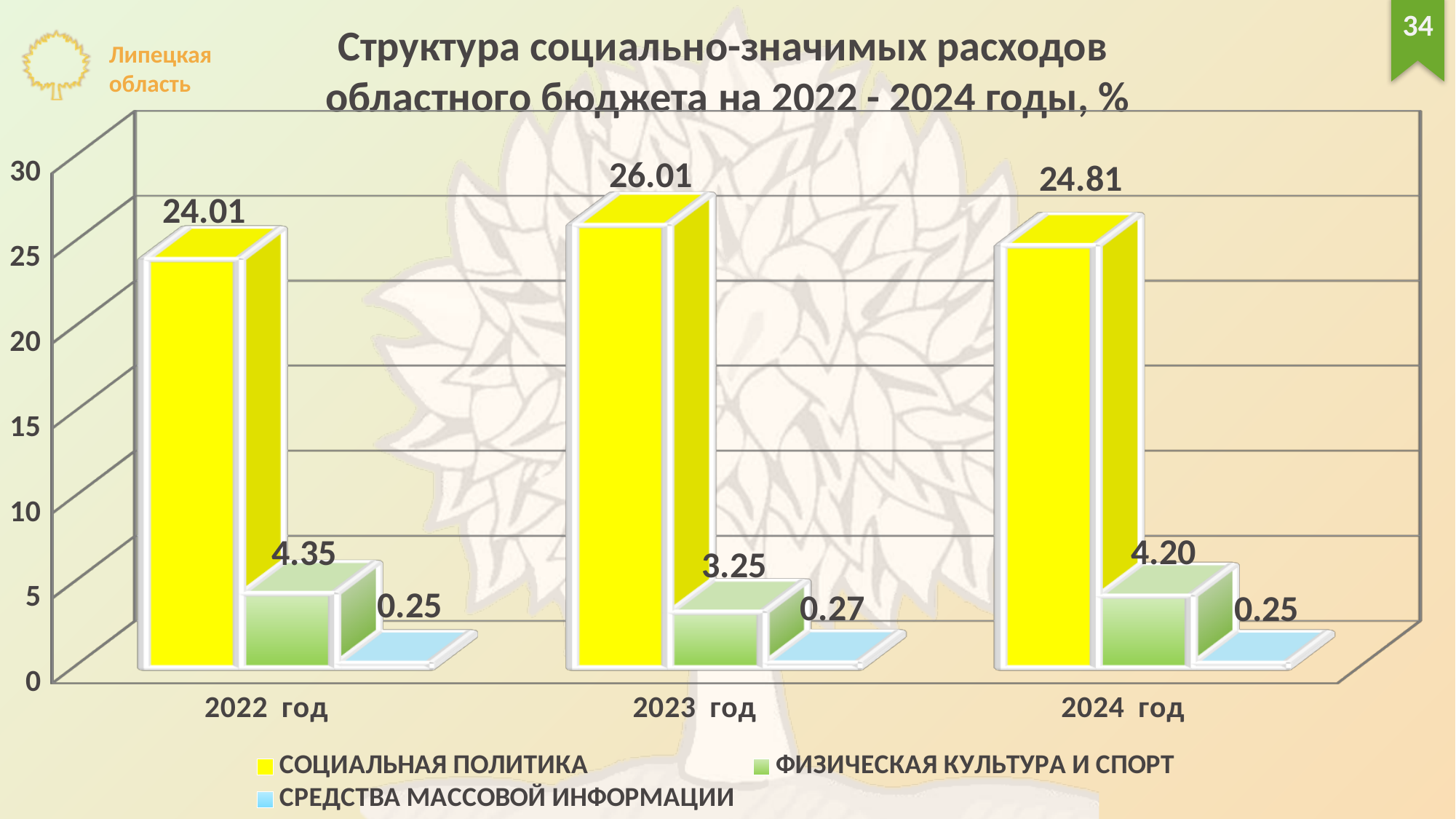
What is the value for СОЦИАЛЬНАЯ ПОЛИТИКА in 2024 год? 24.81 How many years are shown on the x axis? 3 In which year is the value for ФИЗИЧЕСКАЯ КУЛЬТУРА И СПОРТ lowest? 2023 год Is the value for СОЦИАЛЬНАЯ ПОЛИТИКА in 2022 год greater or less than 25? less Which is larger: ФИЗИЧЕСКАЯ КУЛЬТУРА И СПОРТ in 2022 год or in 2024 год? 2022 год How many series does the legend list? 3 What is the value for ФИЗИЧЕСКАЯ КУЛЬТУРА И СПОРТ in 2022 год? 4.35 What is the value for СОЦИАЛЬНАЯ ПОЛИТИКА in 2023 год? 26.01 What kind of chart is shown on the slide? bar chart In which year is the value for СОЦИАЛЬНАЯ ПОЛИТИКА highest? 2023 год What is the difference between the СОЦИАЛЬНАЯ ПОЛИТИКА values for 2023 год and 2022 год? 2.00 What is the value for СРЕДСТВА МАССОВОЙ ИНФОРМАЦИИ in 2023 год? 0.27